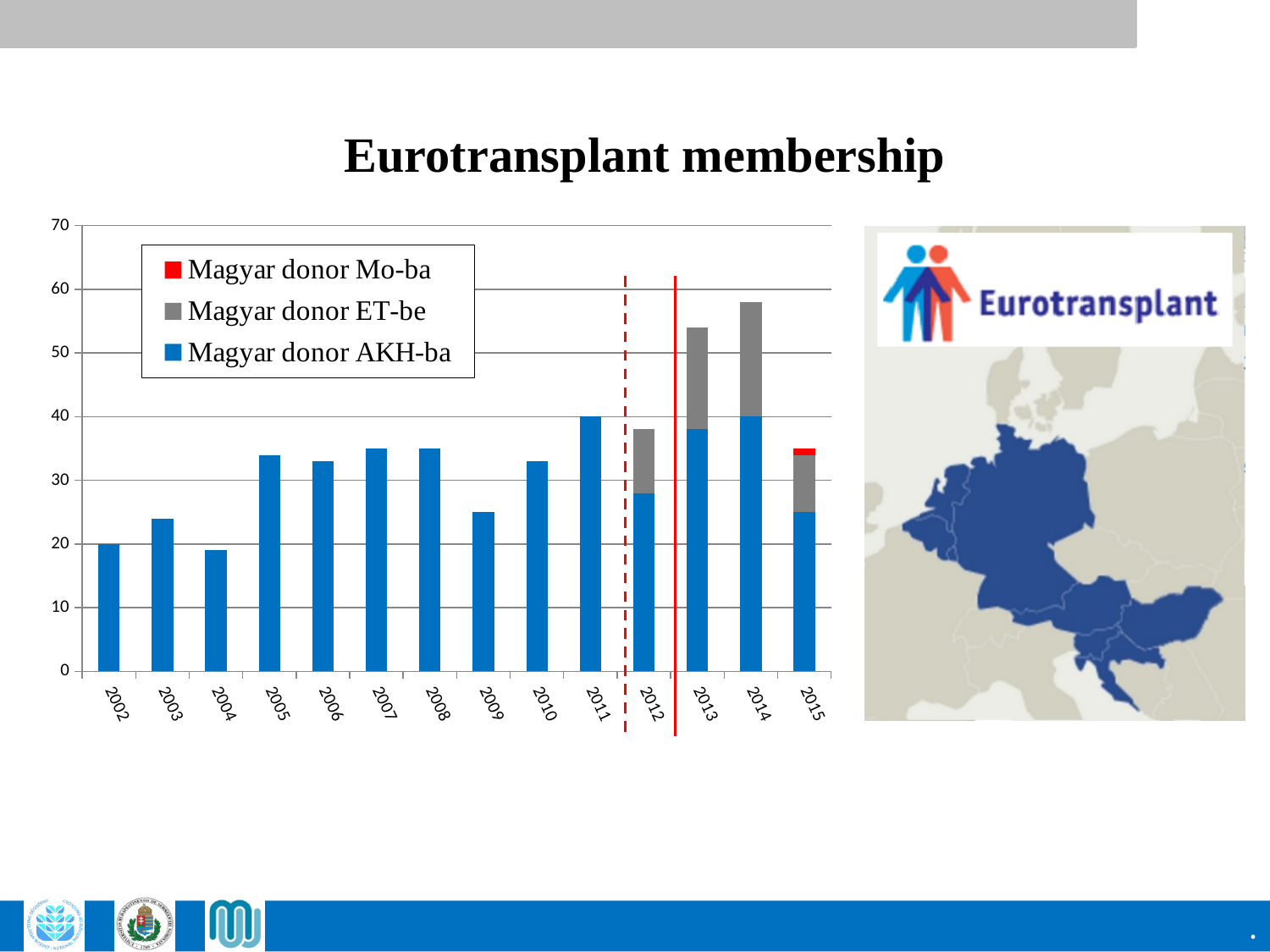
How many years are shown on the x axis of the chart? 14 Which year has the shortest bar? 2004 Do the Magyar donor AKH-ba values rise or fall from 2009 to 2011? rise Which series is shown in red in the legend? Magyar donor Mo-ba What is the title of the slide above the chart? Eurotransplant membership Is the value for Magyar donor AKH-ba in 2013 greater or less than 30? greater What kind of chart is shown on the slide? bar chart How many series does the legend list? 3 Which year has the tallest stacked bar overall? 2014 Which is larger, the Magyar donor AKH-ba value for 2009 or for 2010? 2010 Is the total stacked value for 2013 greater or less than 50? greater Is the total stacked value for 2012 greater or less than 40? less